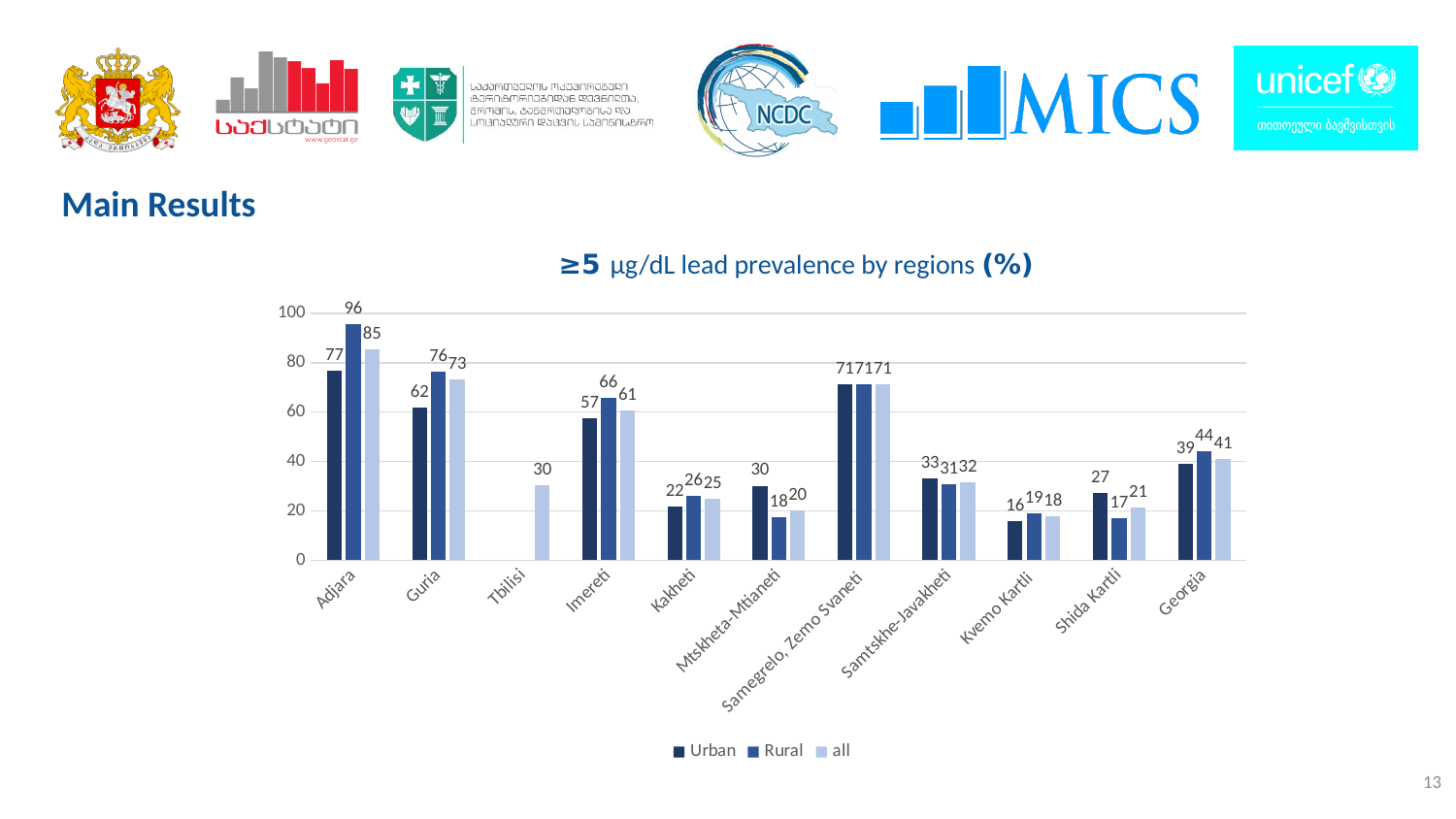
What kind of chart is shown on the slide? Bar chart Which region has the highest Rural value? Adjara What is the Urban value for Georgia? 39 Is the 'all' value for Imereti greater or less than 40? greater Which region has the lowest Urban value? Kvemo Kartli What is the Rural value for Adjara? 96 How many regions are shown on the x axis? 11 What is the title of the chart? ≥5 µg/dL lead prevalence by regions (%) How many series does the legend list? 3 What is the difference between the Rural and Urban values for Adjara? 19 Which is larger for Mtskheta-Mtianeti, the Urban value or the Rural value? Urban What is the 'all' value for Tbilisi? 30